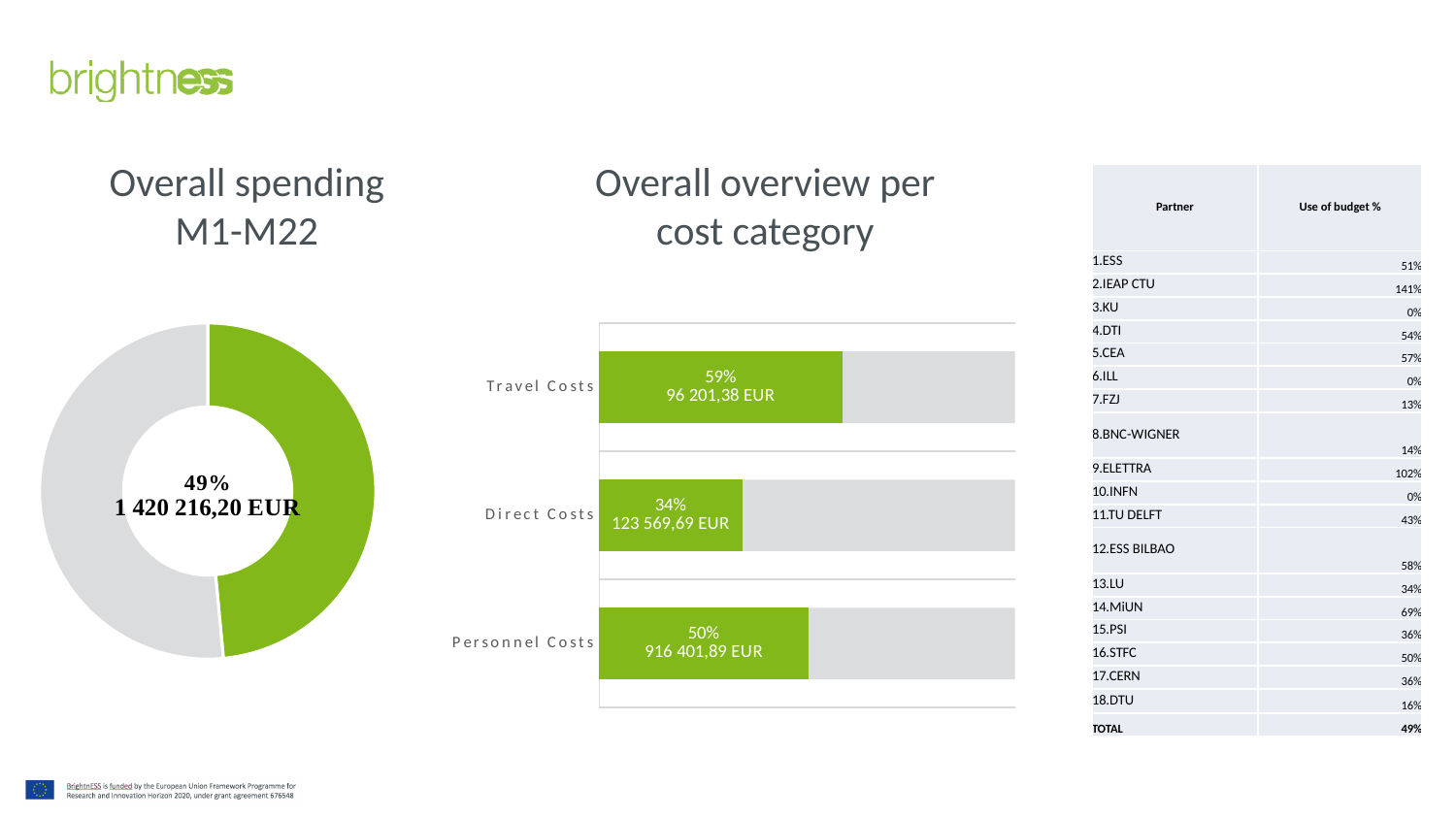
In the 'Overall overview per cost category' chart, what amount in EUR is shown for Direct Costs? 123 569,69 EUR What EUR amount is shown in the centre of the 'Overall spending M1-M22' donut chart? 1 420 216,20 EUR In the 'Overall overview per cost category' chart, what percentage is shown for Direct Costs? 34% In the 'Overall overview per cost category' chart, which cost category has the highest percentage? Travel Costs What type of chart is the 'Overall overview per cost category' chart? Bar chart What percentage is shown in the centre of the 'Overall spending M1-M22' donut chart? 49% In the 'Overall overview per cost category' chart, which has a higher percentage, Personnel Costs or Direct Costs? Personnel Costs In the 'Overall overview per cost category' chart, which cost category has the lowest percentage? Direct Costs In the 'Overall overview per cost category' chart, what amount in EUR is shown for Personnel Costs? 916 401,89 EUR In the 'Overall overview per cost category' chart, what is the difference in percentage points between Travel Costs and Direct Costs? 25 How many cost categories are shown in the 'Overall overview per cost category' chart? 3 In the 'Overall overview per cost category' chart, what percentage is shown for Travel Costs? 59%